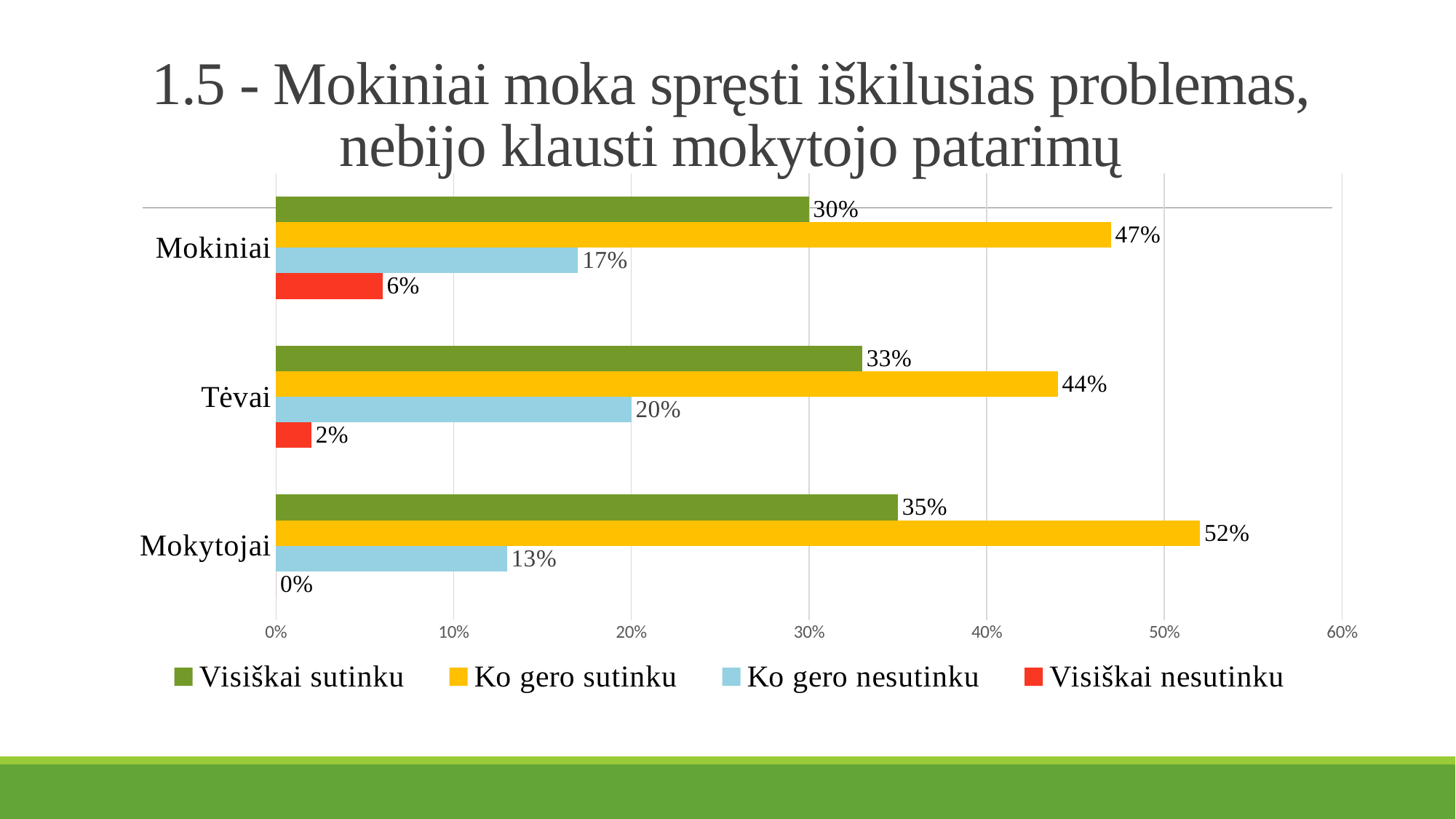
How many groups are shown on the vertical axis? 3 What is the value for "Visiškai nesutinku" for Mokiniai? 6% Which colour represents "Ko gero nesutinku" in the legend? Light blue What is the difference between the "Ko gero sutinku" values for Mokiniai and Tėvai? 3% How many series does the legend list? 4 What is the value for "Ko gero nesutinku" for Tėvai? 20% Which is larger: "Visiškai sutinku" for Tėvai or "Visiškai sutinku" for Mokiniai? Tėvai What is the value for "Ko gero sutinku" for Mokytojai? 52% What is the value for "Visiškai nesutinku" for Mokytojai? 0% Which group has the lowest value for "Ko gero nesutinku"? Mokytojai What kind of chart is shown on the slide? Bar chart Which group has the highest value for "Visiškai sutinku"? Mokytojai